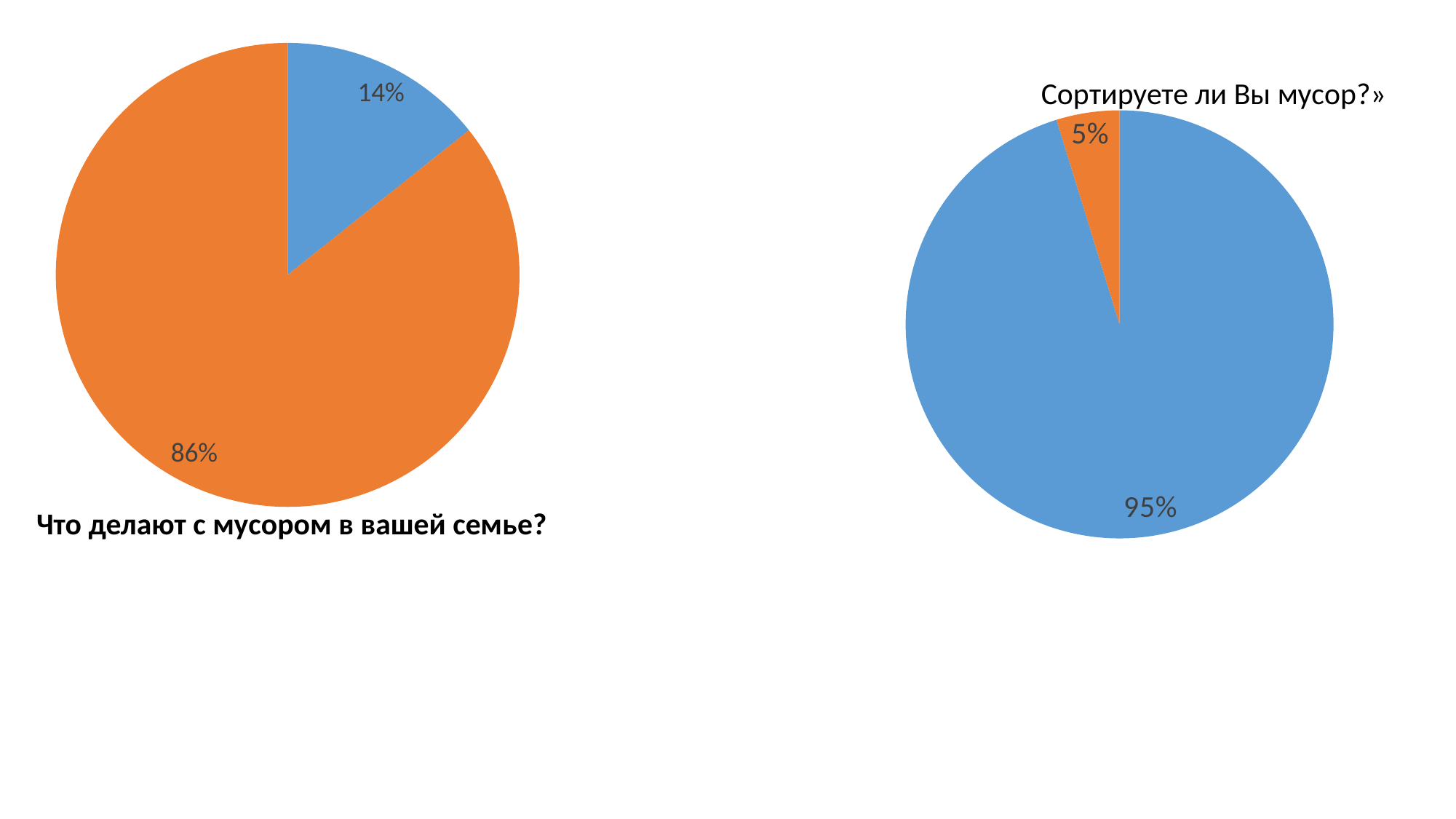
In the right pie chart titled "Сортируете ли Вы мусор?", what percentage is shown on the blue slice? 95% In the right pie chart titled "Сортируете ли Вы мусор?", what percentage is shown on the orange slice? 5% In the right pie chart, what is the difference in percentage points between the blue slice and the orange slice? 90 In the left pie chart titled "Что делают с мусором в вашей семье?", what percentage is shown on the blue slice? 14% In the right pie chart, which slice is larger, the blue one or the orange one? blue What is the title of the pie chart on the left side of the slide? Что делают с мусором в вашей семье? In the left pie chart, which slice is larger, the blue one or the orange one? orange What type of chart is shown on the right side of the slide? pie chart How many slices does the right pie chart have? 2 In the left pie chart, what is the difference in percentage points between the orange slice and the blue slice? 72 In the left pie chart titled "Что делают с мусором в вашей семье?", what percentage is shown on the orange slice? 86% How many slices does the left pie chart have? 2